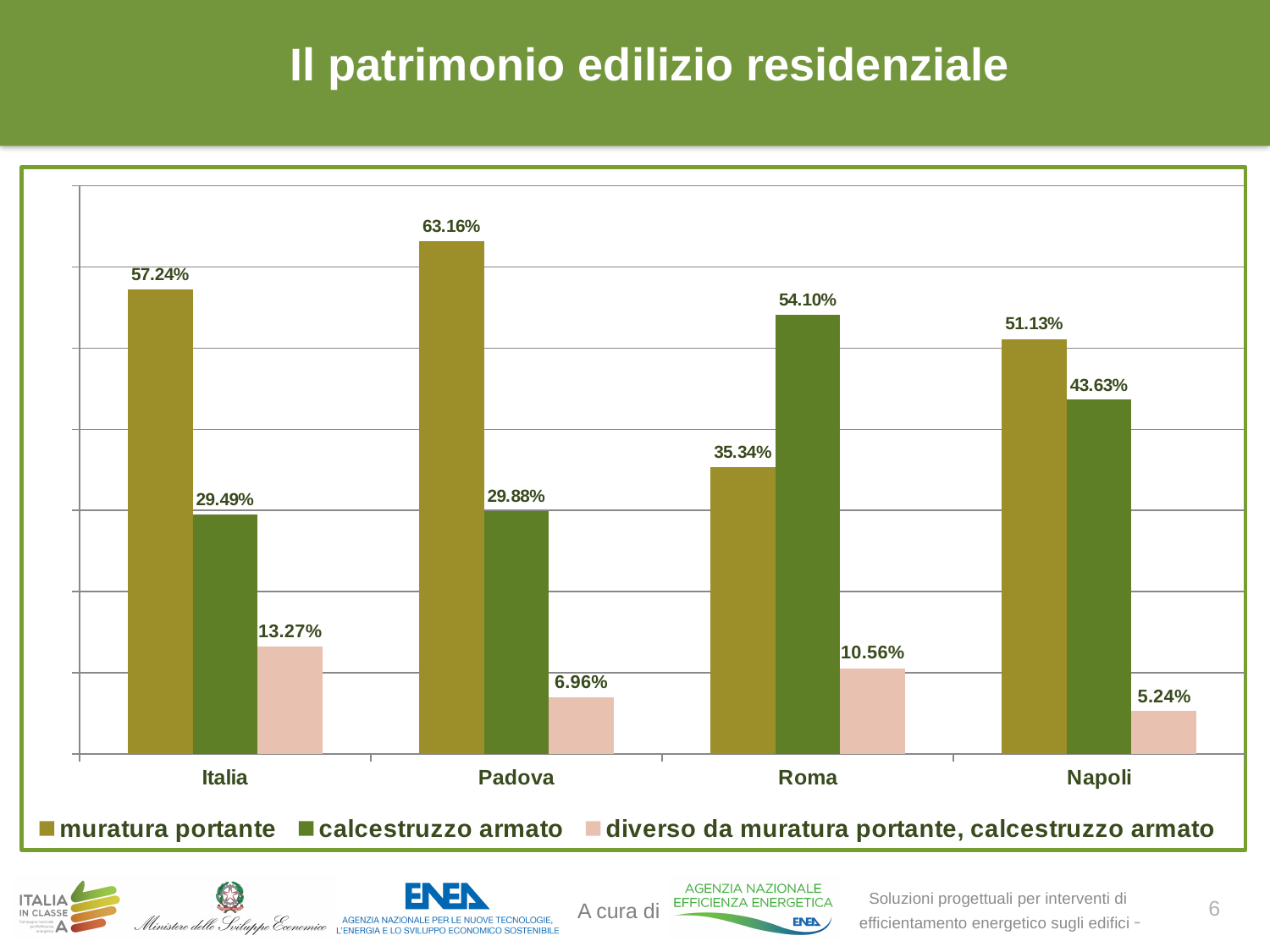
How many series does the legend list? 3 What is the value for calcestruzzo armato in Roma? 54.10% What is the value for muratura portante in Padova? 63.16% How many categories are shown on the x axis? 4 What is the title of the slide containing the chart? Il patrimonio edilizio residenziale What is the value for diverso da muratura portante, calcestruzzo armato in Napoli? 5.24% Which category has the highest value for muratura portante? Padova Which category has the lowest value for diverso da muratura portante, calcestruzzo armato? Napoli Which is larger in Roma: muratura portante or calcestruzzo armato? calcestruzzo armato What is the difference between the calcestruzzo armato values for Napoli and Padova? 13.75% What is the difference between the muratura portante values for Italia and Roma? 21.90% What kind of chart is shown on the slide? bar chart